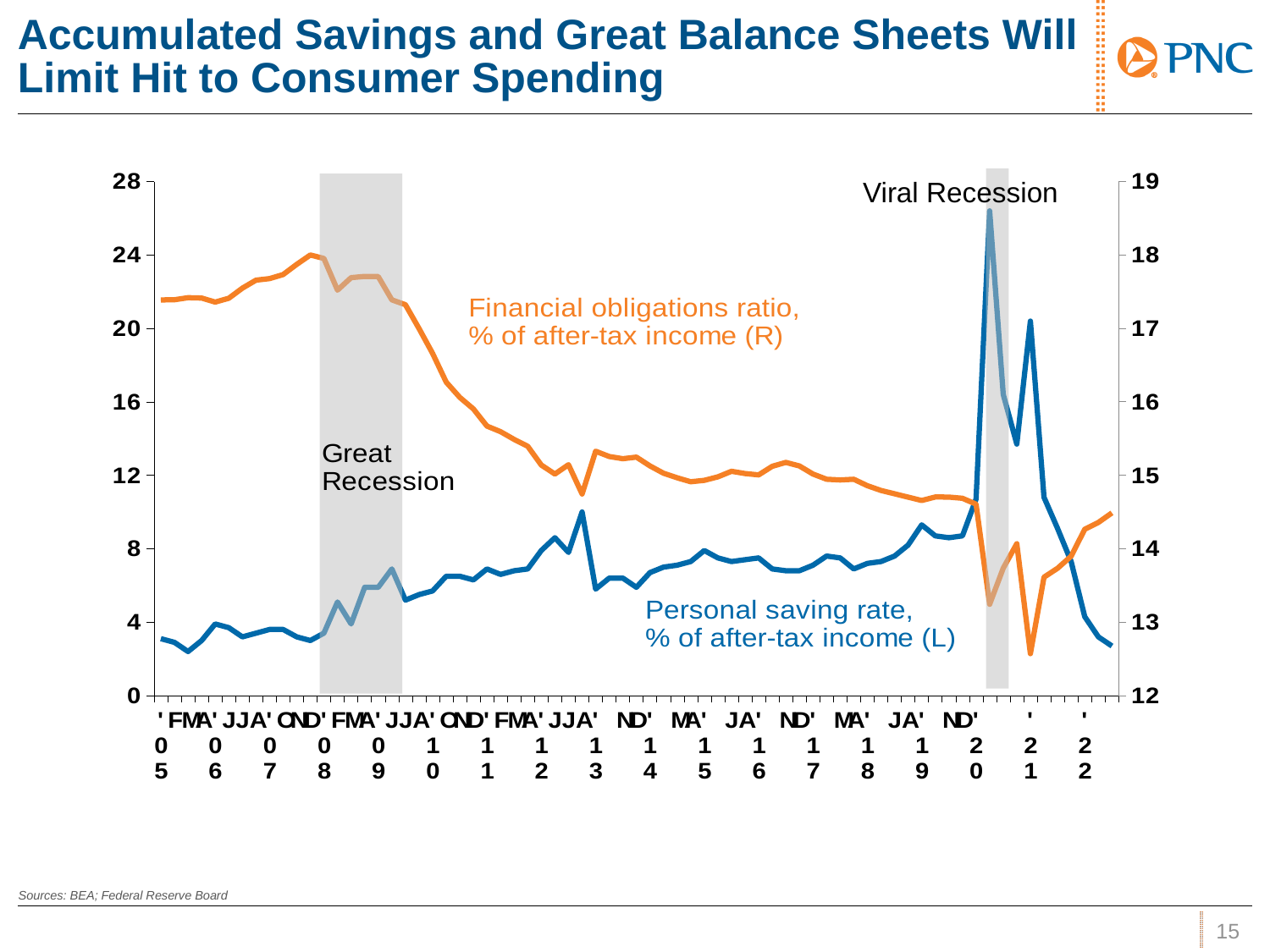
In which year does the personal saving rate reach its highest point? 2020 Is the personal saving rate at the start of 2005 greater or less than 4 on the left axis? less Does the financial obligations ratio rise or fall between 2008 and 2019? Fall What are the two shaded recession periods labelled on the chart? Great Recession and Viral Recession Is the lowest value of the financial obligations ratio in 2021 greater or less than 13 on the right axis? less Which series is plotted against the left axis? Personal saving rate, % of after-tax income Is the peak value of the personal saving rate during the Viral Recession greater or less than 24 on the left axis? greater What kind of chart is shown on the slide? Line chart How many data series are plotted on the chart? 2